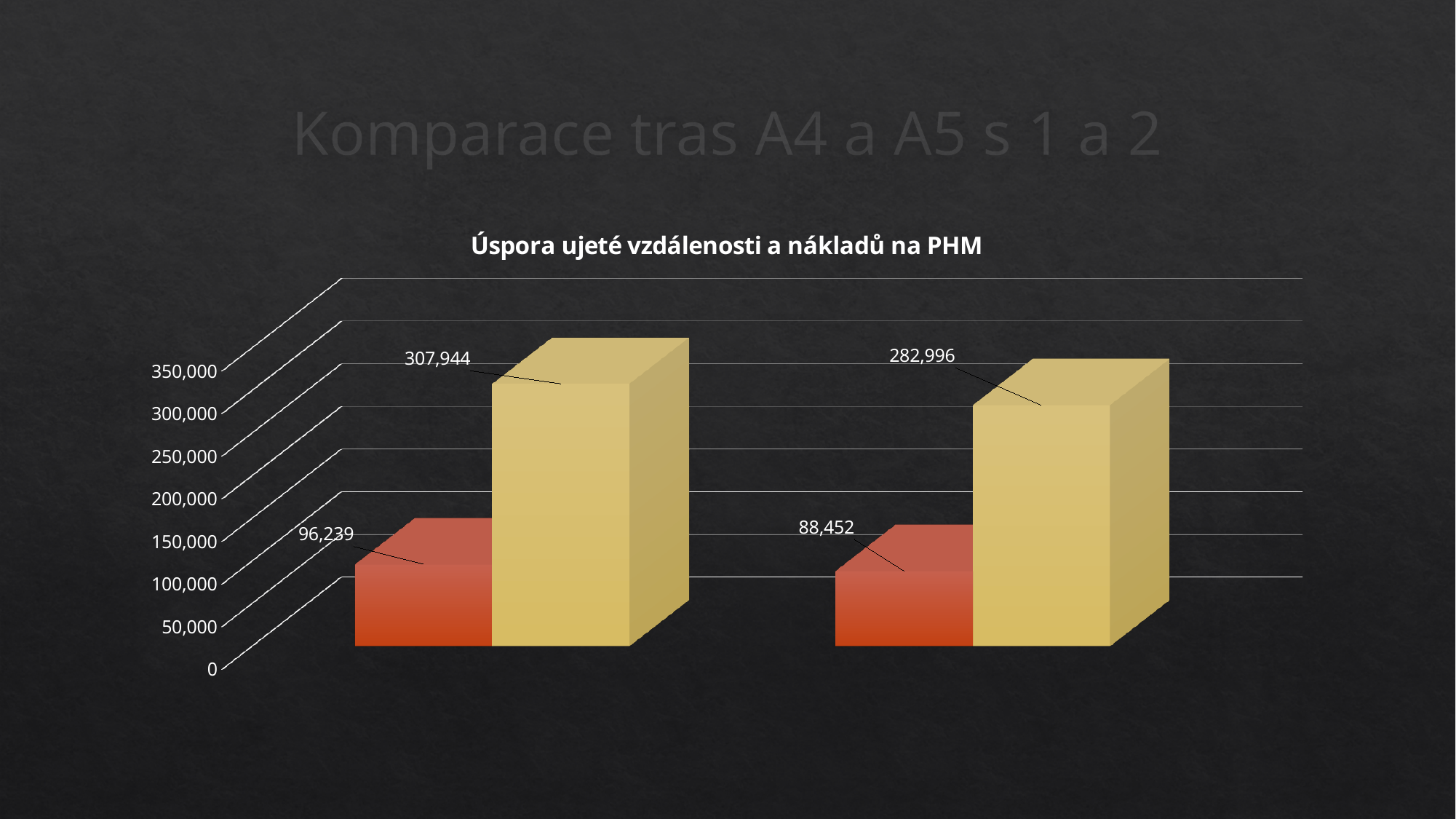
Which is larger: the red bar in the left group or the red bar in the right group? the red bar in the left group What is the value of the yellow bar in the left group? 307,944 What is the value of the yellow bar in the right group? 282,996 What is the difference between the yellow bar in the left group and the yellow bar in the right group? 24,948 What is the value of the red bar in the right group? 88,452 How many bars are plotted on the chart? 4 What kind of chart is shown on the slide? bar chart What is the title of the chart? Úspora ujeté vzdálenosti a nákladů na PHM Which bar has the highest value on the chart? the yellow bar in the left group (307,944) Which bar has the lowest value on the chart? the red bar in the right group (88,452) What is the value of the red bar in the left group? 96,239 What is the difference between the red bar in the left group and the red bar in the right group? 7,787